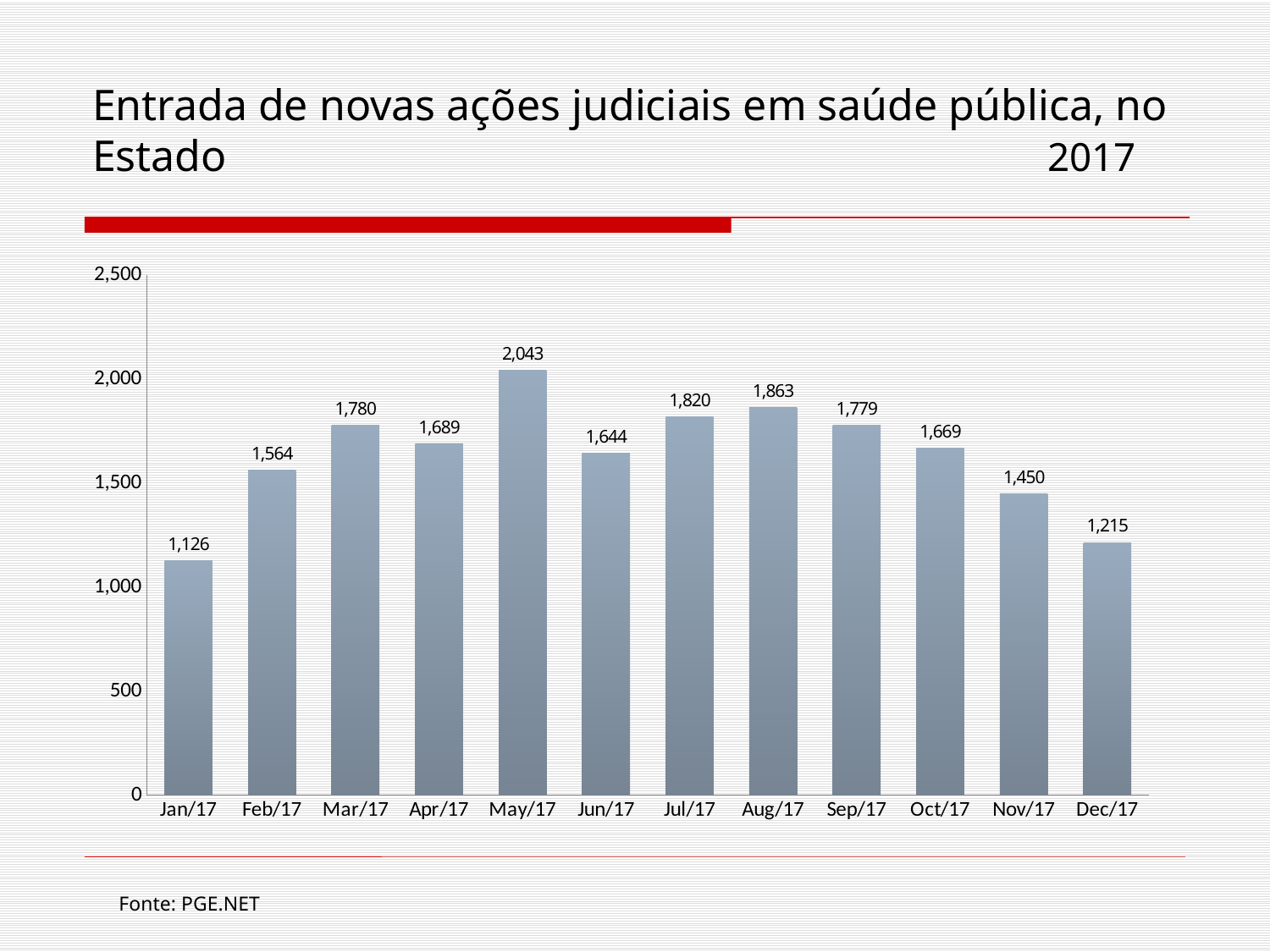
Do the values rise or fall from Sep/17 to Dec/17? fall Is the value for Nov/17 greater or less than 1,500? less Which month has the highest value? May/17 How many months are shown on the x axis? 12 What is the value for Oct/17? 1,669 What is the value for May/17? 2,043 Which month has the lowest value? Jan/17 What is the difference between the values for Aug/17 and Jul/17? 43 What is the difference between the values for May/17 and Dec/17? 828 Which is larger, the value for Mar/17 or the value for Apr/17? Mar/17 What kind of chart is shown on the slide? bar chart What is the value for Jan/17? 1,126